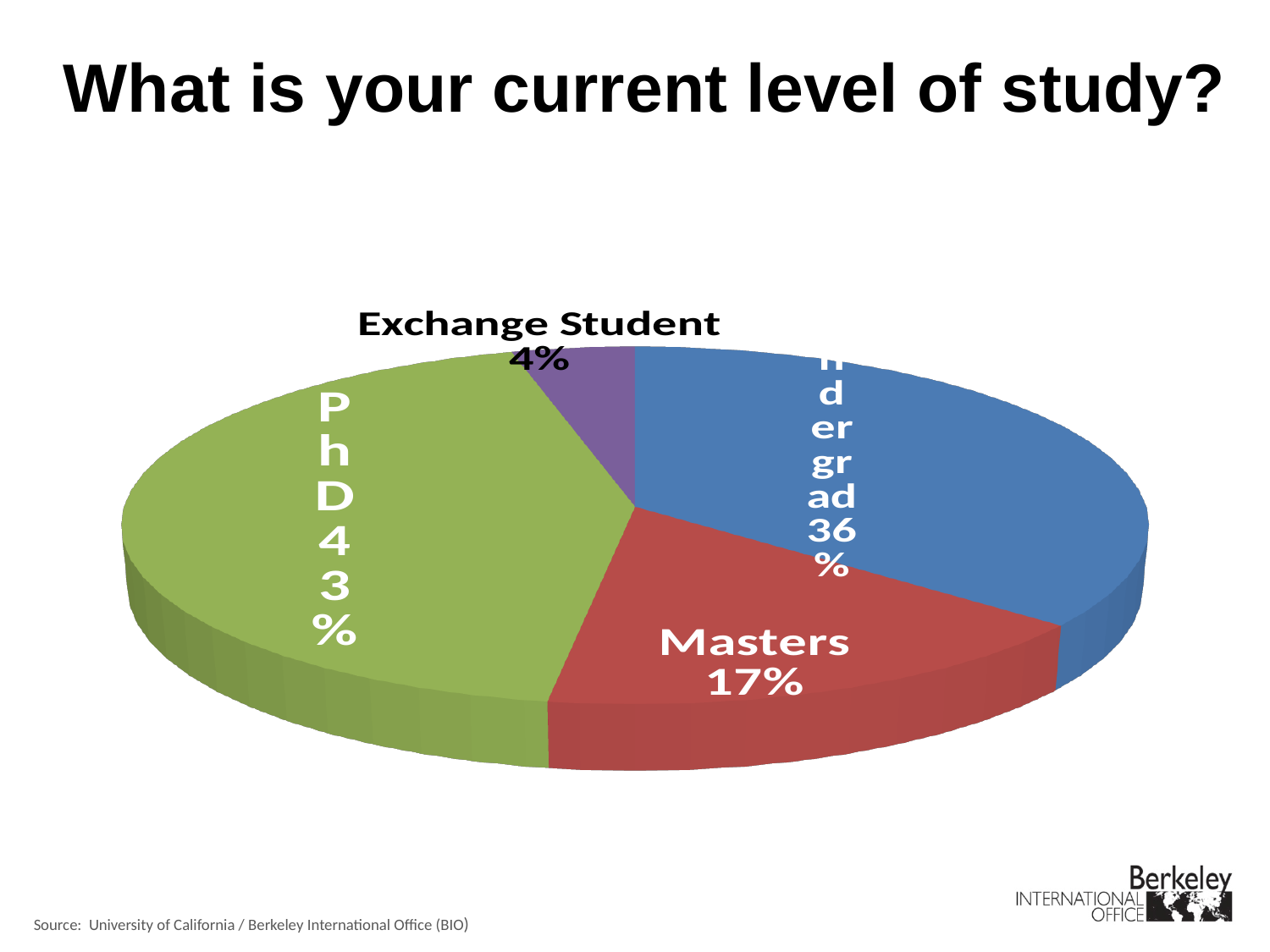
What percentage of respondents are PhD students? 43% What is the title of the slide? What is your current level of study? What percentage of respondents are Masters students? 17% How many percentage points larger is the PhD share than the Masters share? 26 percentage points What kind of chart is shown on the slide? Pie chart How many slices does the pie chart have? 4 Which is larger, the PhD share or the Masters share? PhD What percentage of respondents are Undergrad students? 36% How many percentage points larger is the Masters share than the Exchange Student share? 13 percentage points Which level of study has the smallest share of the pie? Exchange Student What percentage of respondents are Exchange Students? 4% Which level of study has the largest share of the pie? PhD